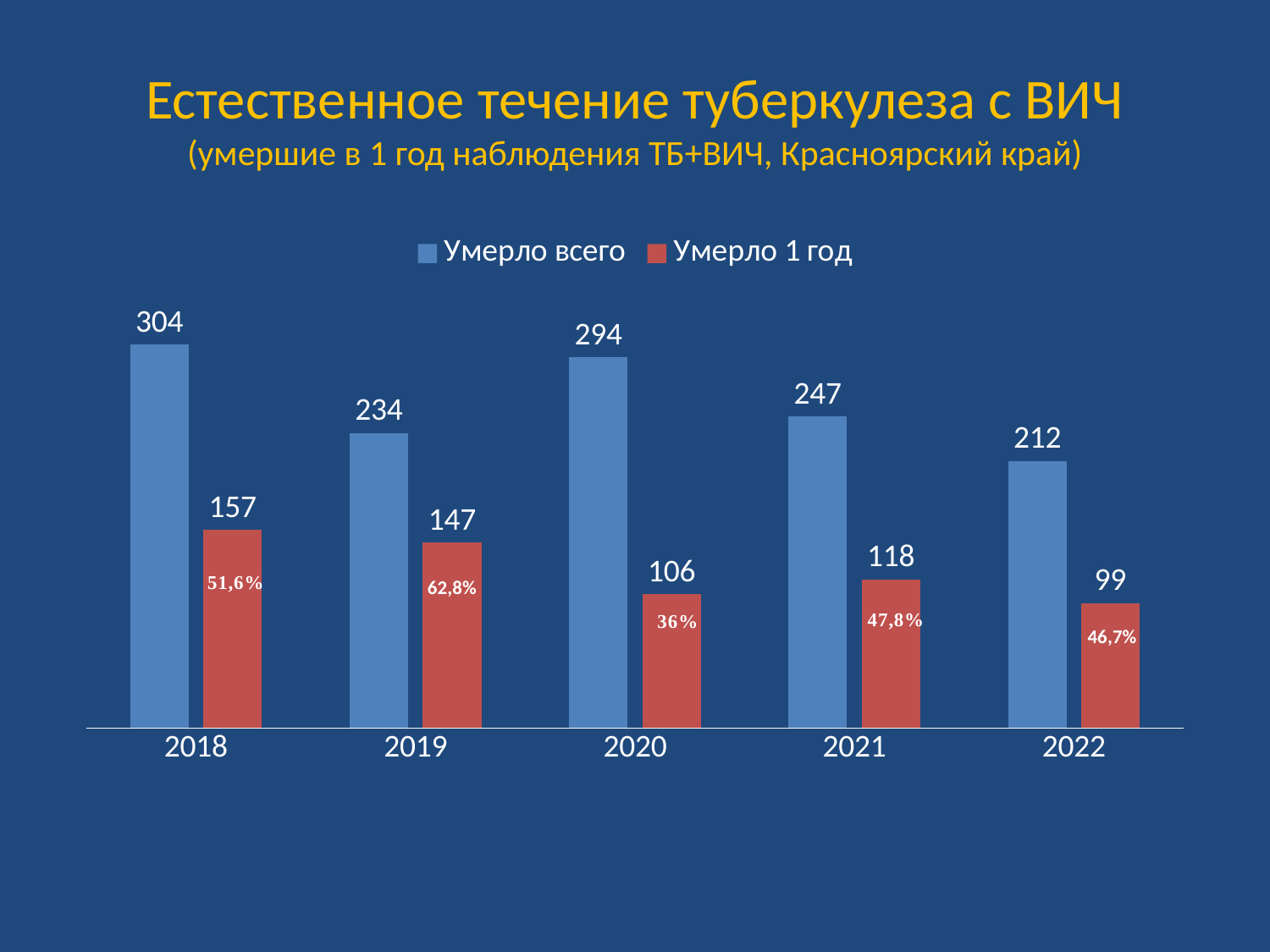
What is the value of "Умерло всего" for 2018? 304 What is the difference between "Умерло всего" and "Умерло 1 год" in 2021? 129 What percentage is printed on the "Умерло 1 год" bar for 2019? 62,8% Does the value of "Умерло всего" rise or fall from 2020 to 2022? Falls How many series does the legend list? 2 How many years are shown on the x axis? 5 Which is larger: "Умерло всего" in 2019 or "Умерло всего" in 2020? 2020 What kind of chart is shown on the slide? Bar chart Which year has the lowest value for "Умерло 1 год"? 2022 Which year has the highest value for "Умерло всего"? 2018 What colour are the "Умерло 1 год" bars? Red What is the value of "Умерло 1 год" for 2020? 106